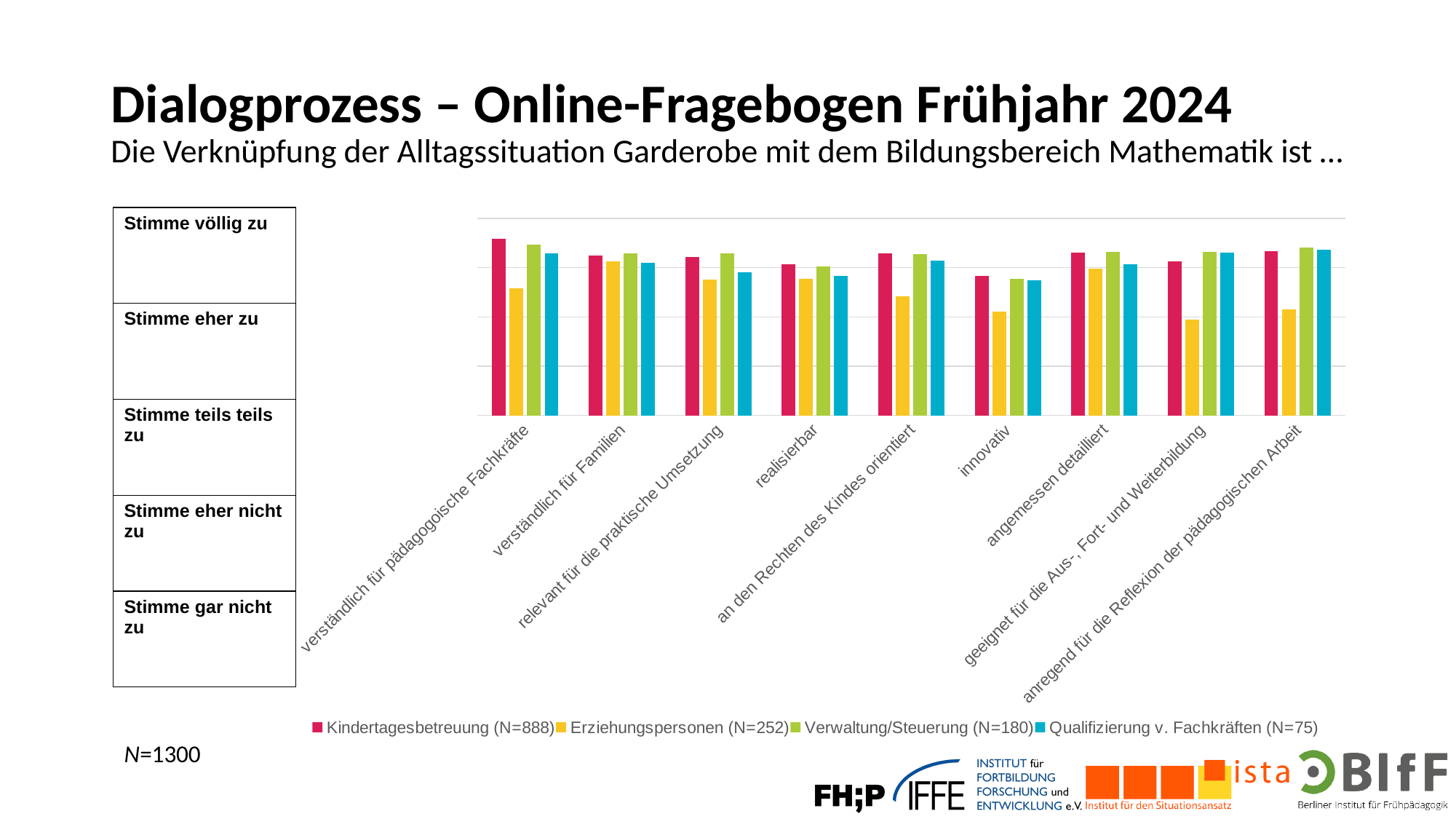
Which series has the lowest bar in the category 'geeignet für die Aus-, Fort- und Weiterbildung'? Erziehungspersonen (N=252) In the category 'innovativ', which is higher: the Kindertagesbetreuung bar or the Erziehungspersonen bar? Kindertagesbetreuung What is the total N stated on the slide? N=1300 Which series in the legend has the largest sample size (N)? Kindertagesbetreuung (N=888) What kind of chart is shown on the slide? bar chart In the category 'an den Rechten des Kindes orientiert', which is higher: the Erziehungspersonen bar or the Verwaltung/Steuerung bar? Verwaltung/Steuerung For which category is the Kindertagesbetreuung bar the highest? verständlich für pädagogoische Fachkräfte How many categories are shown along the x axis of the chart? 9 In the category 'verständlich für pädagogische Fachkräfte', which series has the lowest bar? Erziehungspersonen (N=252) How many series does the chart's legend list? 4 For which category is the Kindertagesbetreuung bar the lowest? innovativ In the category 'anregend für die Reflexion der pädagogischen Arbeit', which is higher: the Erziehungspersonen bar or the Qualifizierung v. Fachkräften bar? Qualifizierung v. Fachkräften